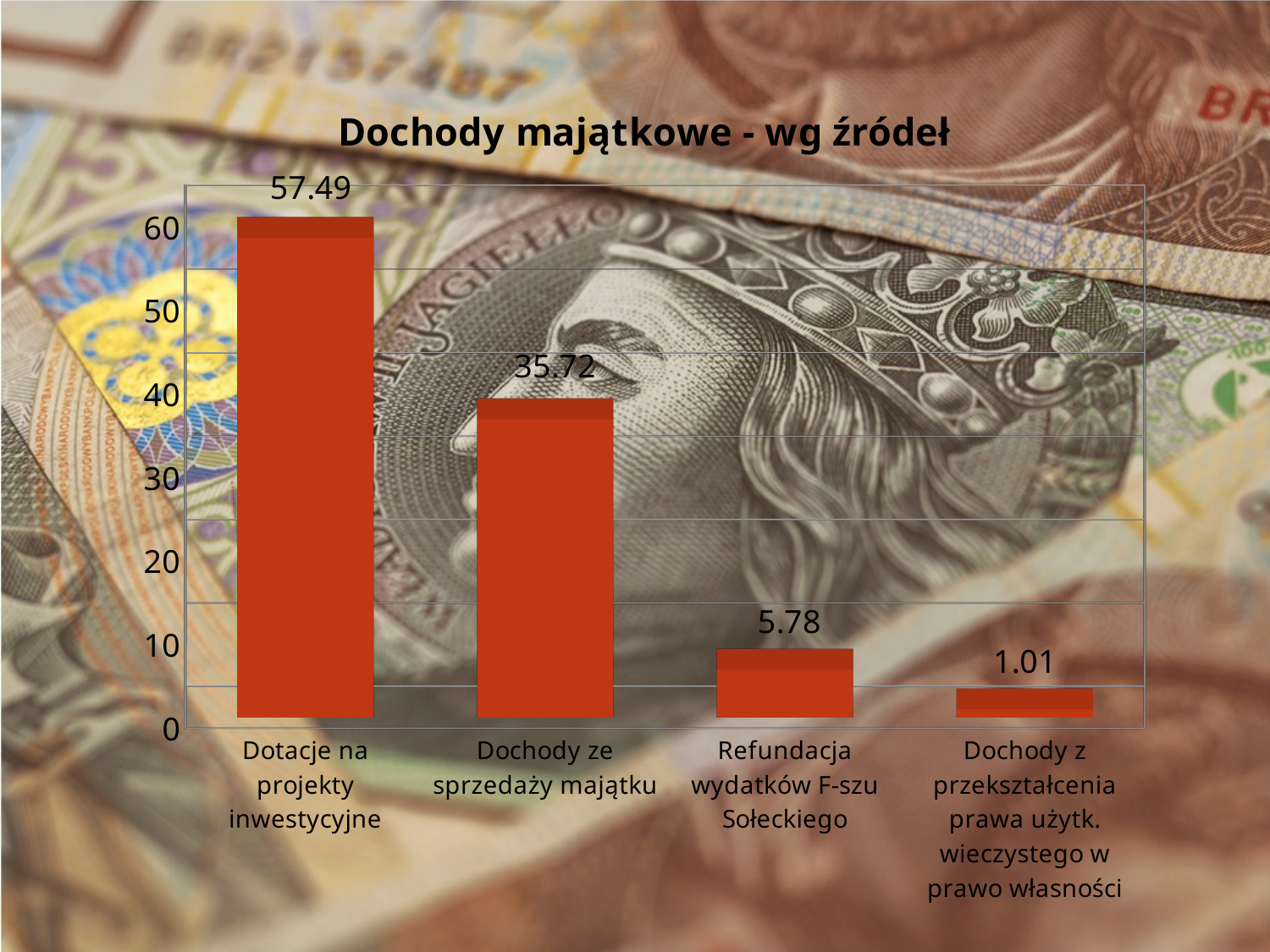
What is the value for Dotacje na projekty inwestycyjne? 57.49 How many categories are shown in the chart? 4 What is the value for Dochody z przekształcenia prawa użytk. wieczystego w prawo własności? 1.01 Which category has the highest value? Dotacje na projekty inwestycyjne Which is larger: the value for Refundacja wydatków F-szu Sołeckiego or the value for Dochody z przekształcenia prawa użytk. wieczystego w prawo własności? Refundacja wydatków F-szu Sołeckiego What is the difference between the values for Dotacje na projekty inwestycyjne and Dochody ze sprzedaży majątku? 21.77 What is the value for Refundacja wydatków F-szu Sołeckiego? 5.78 What is the title of the chart? Dochody majątkowe - wg źródeł What kind of chart is shown on the slide? bar chart Which category has the lowest value? Dochody z przekształcenia prawa użytk. wieczystego w prawo własności Is the value for Dochody ze sprzedaży majątku greater or less than 40? less What is the value for Dochody ze sprzedaży majątku? 35.72